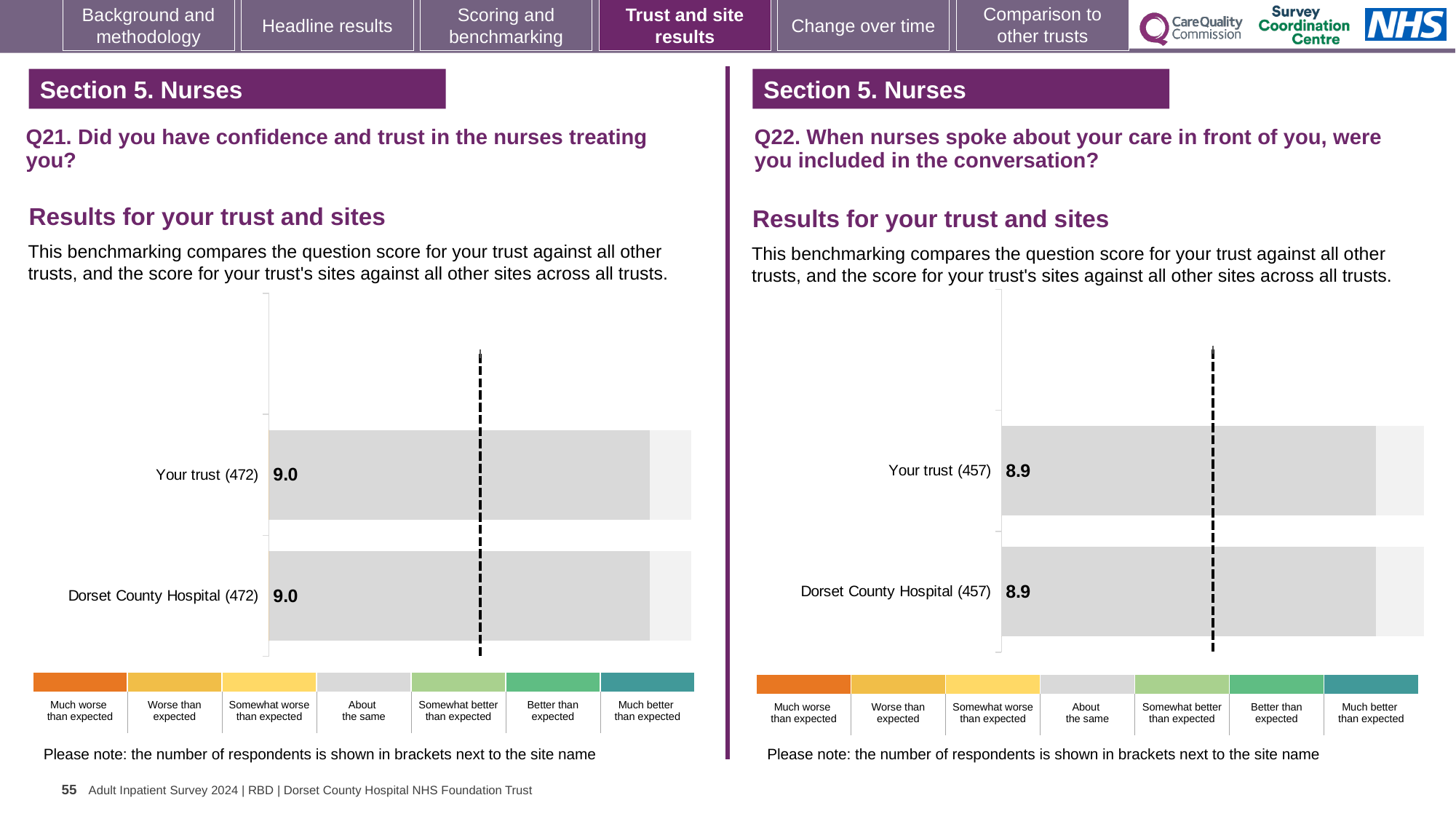
On the Q21 chart (left), how many respondents are shown in brackets next to Your trust? 472 On the Q22 chart (right), what is the difference between the score for Your trust and the score for Dorset County Hospital? 0.0 On the Q22 chart (right), what is the score for Dorset County Hospital? 8.9 On the Q21 chart (left), what is the difference between the score for Your trust and the score for Dorset County Hospital? 0.0 What kind of chart is the Q21 chart on the left? Bar chart On the Q21 chart (left), what is the score for Your trust? 9.0 On the Q22 chart (right), how many bars are plotted? 2 Is the score for Your trust on the Q21 chart (left) larger or smaller than the score for Your trust on the Q22 chart (right)? Larger On the Q21 chart (left), what is the score for Dorset County Hospital? 9.0 On the Q22 chart (right), what is the score for Your trust? 8.9 On the Q22 chart (right), how many respondents are shown in brackets next to Dorset County Hospital? 457 On the Q21 chart (left), how many bars are plotted? 2